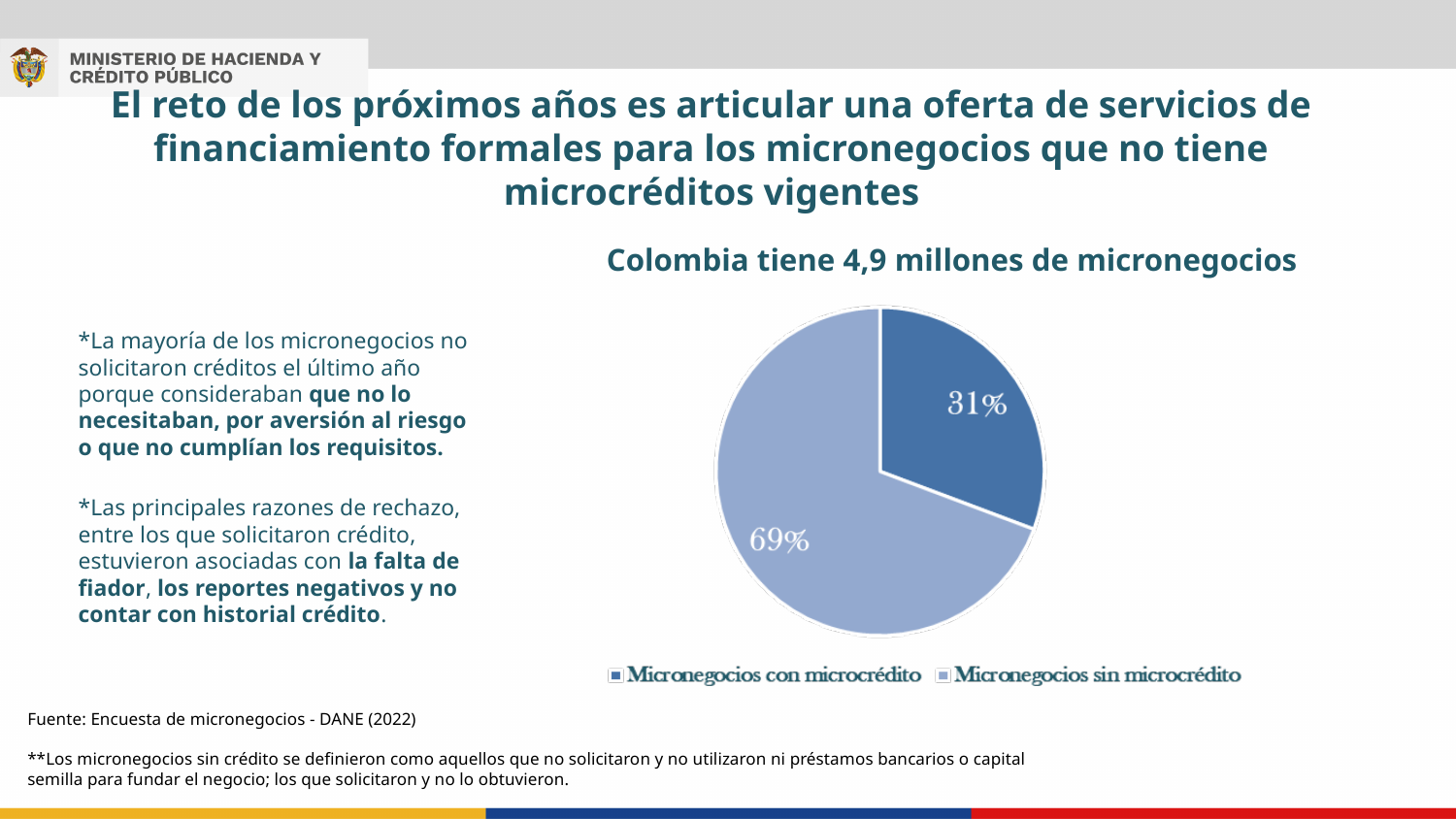
Which is larger: the share of micronegocios con microcrédito or the share sin microcrédito? Micronegocios sin microcrédito What kind of chart is shown on the slide? Pie chart Which legend entry is shown in the darker blue colour? Micronegocios con microcrédito What is the title shown above the pie chart? Colombia tiene 4,9 millones de micronegocios What share of micronegocios have microcrédito (Micronegocios con microcrédito)? 31% How many slices does the pie chart have? 2 Is the share of micronegocios con microcrédito greater or less than 50%? less What share of micronegocios do not have microcrédito (Micronegocios sin microcrédito)? 69% What is the difference in percentage points between the 'sin microcrédito' slice and the 'con microcrédito' slice? 38 percentage points How many entries does the legend list? 2 Which slice of the pie is the smallest? Micronegocios con microcrédito Which slice of the pie is the largest? Micronegocios sin microcrédito